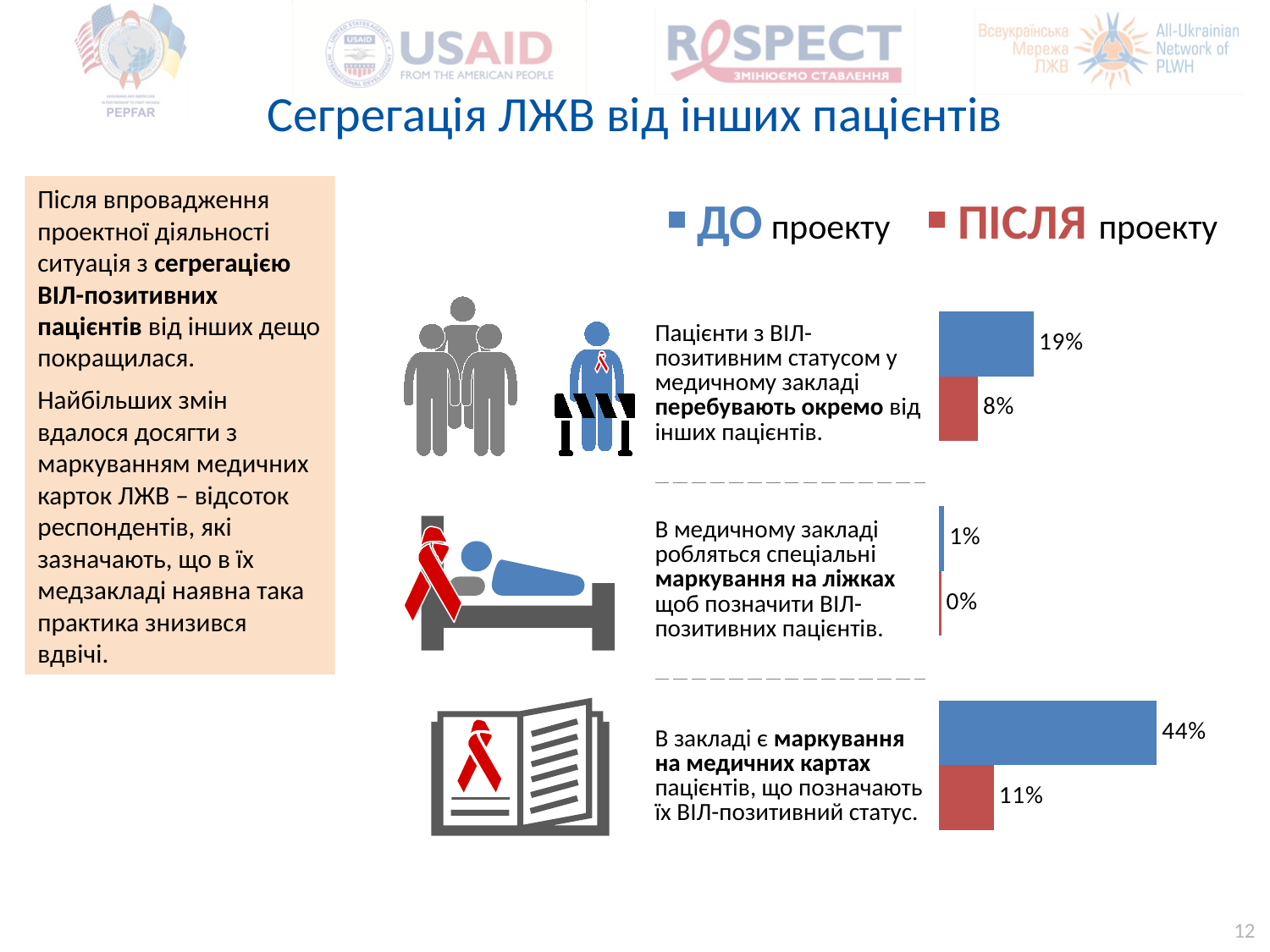
What is the value for 'ДО проекту' for patients with HIV-positive status being kept separately (перебувають окремо) from other patients? 19% What is the value for 'ДО проекту' for special markings on beds (маркування на ліжках)? 1% How many series does the legend list? 2 What kind of chart is shown on the slide? bar chart What are the two series named in the legend? ДО проекту and ПІСЛЯ проекту What is the value for 'ДО проекту' for markings on medical cards (маркування на медичних картах)? 44% What is the value for 'ПІСЛЯ проекту' for patients with HIV-positive status being kept separately (перебувають окремо) from other patients? 8% What is the value for 'ПІСЛЯ проекту' for markings on medical cards (маркування на медичних картах)? 11% What is the value for 'ПІСЛЯ проекту' for special markings on beds (маркування на ліжках)? 0% What is the difference between the 'ДО проекту' and 'ПІСЛЯ проекту' values for markings on medical cards (маркування на медичних картах)? 33% Which category has the highest 'ДО проекту' value? маркування на медичних картах (markings on medical cards) How many categories (statements) are plotted in the chart? 3